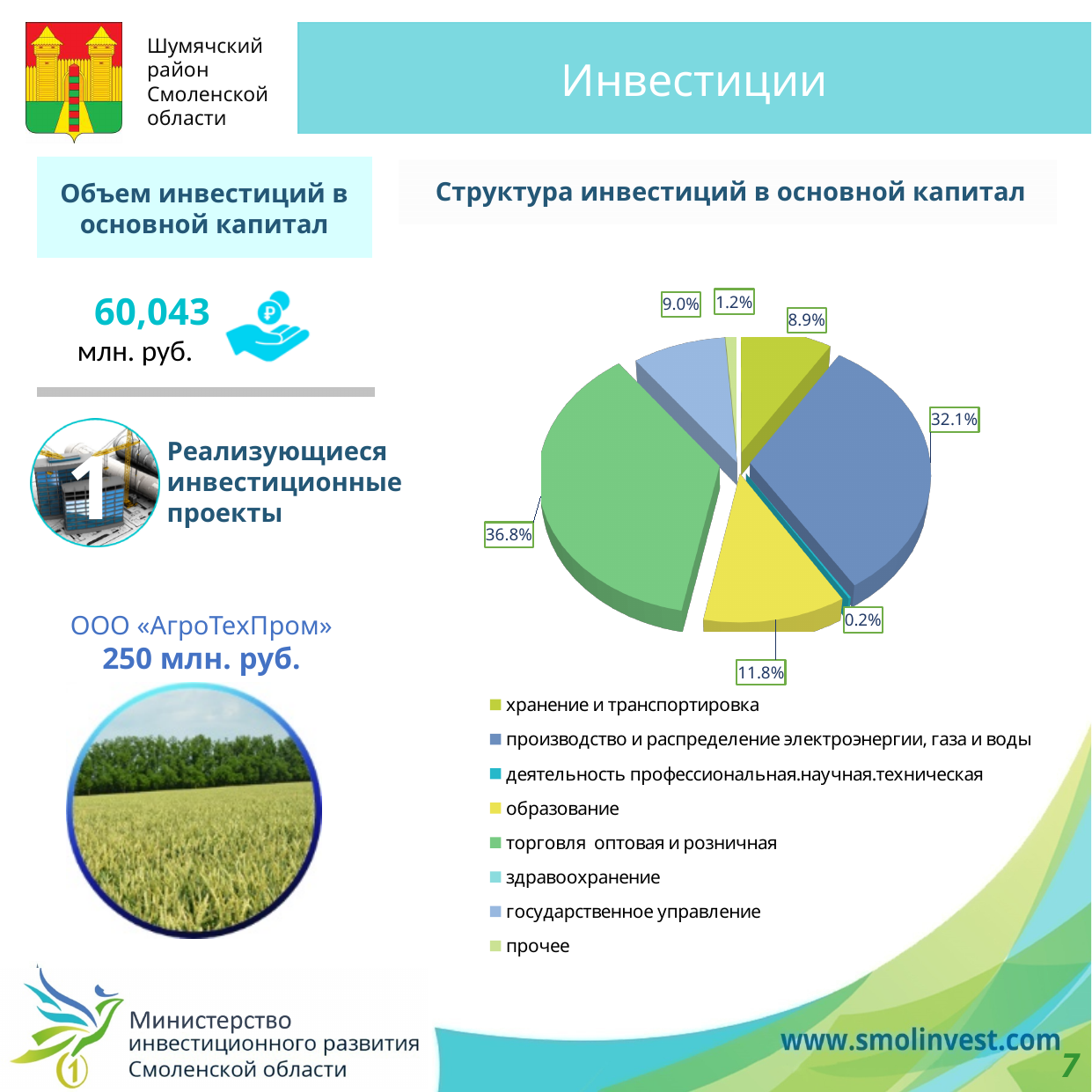
How many entries does the legend of the pie chart list? 8 What is the title of the pie chart? Структура инвестиций в основной капитал What share of the pie chart does 'производство и распределение электроэнергии, газа и воды' have? 32.1% What kind of chart is shown under the heading 'Структура инвестиций в основной капитал'? pie chart What share of the pie chart does 'прочее' have? 1.2% What share of the pie chart does 'хранение и транспортировка' have? 8.9% What share of the pie chart does 'торговля оптовая и розничная' have? 36.8% Which category has the largest slice in the pie chart? торговля оптовая и розничная Which category is labeled 0.2% in the pie chart? деятельность профессиональная.научная.техническая What share of the pie chart does 'образование' have? 11.8% What share of the pie chart does 'государственное управление' have? 9.0% By how many percentage points does the 'торговля оптовая и розничная' slice exceed the 'производство и распределение электроэнергии, газа и воды' slice? 4.7